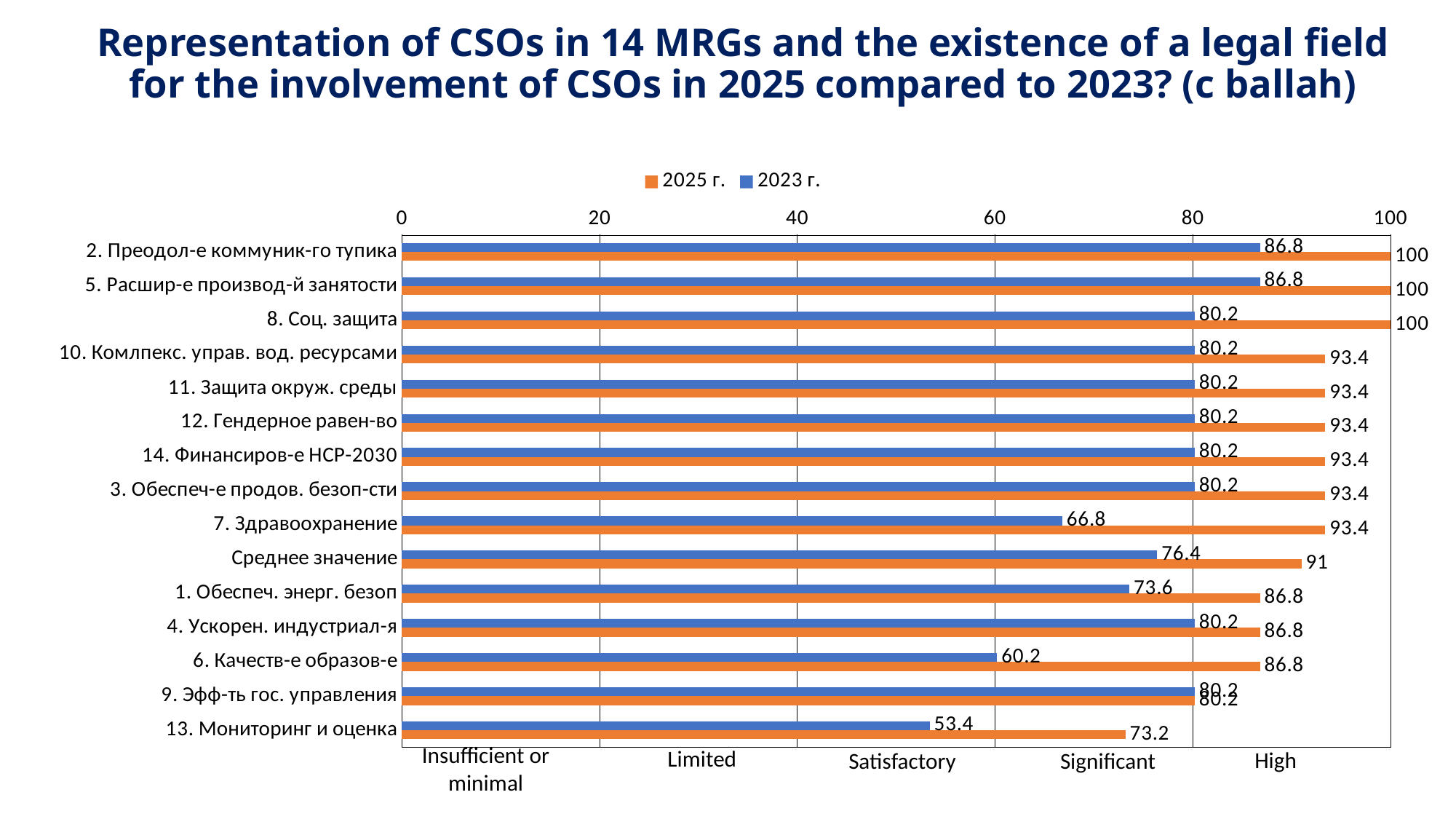
How many categories are plotted on the chart? 15 Which category has the lowest 2023 г. value? 13. Мониторинг и оценка What is the difference between the 2025 г. and 2023 г. values for 6. Качеств-е образов-е? 26.6 What is the 2025 г. value for 13. Мониторинг и оценка? 73.2 What type of chart is shown on the slide? bar chart Which colour represents the 2025 г. series in the legend? orange How many series does the legend list? 2 What is the 2023 г. value for 7. Здравоохранение? 66.8 What is the difference between the 2025 г. values for 8. Соц. защита and 13. Мониторинг и оценка? 26.8 What is the 2023 г. value for 9. Эфф-ть гос. управления? 80.2 What is the 2025 г. value for Среднее значение? 91 Which is larger for 1. Обеспеч. энерг. безоп: the 2025 г. value or the 2023 г. value? 2025 г.